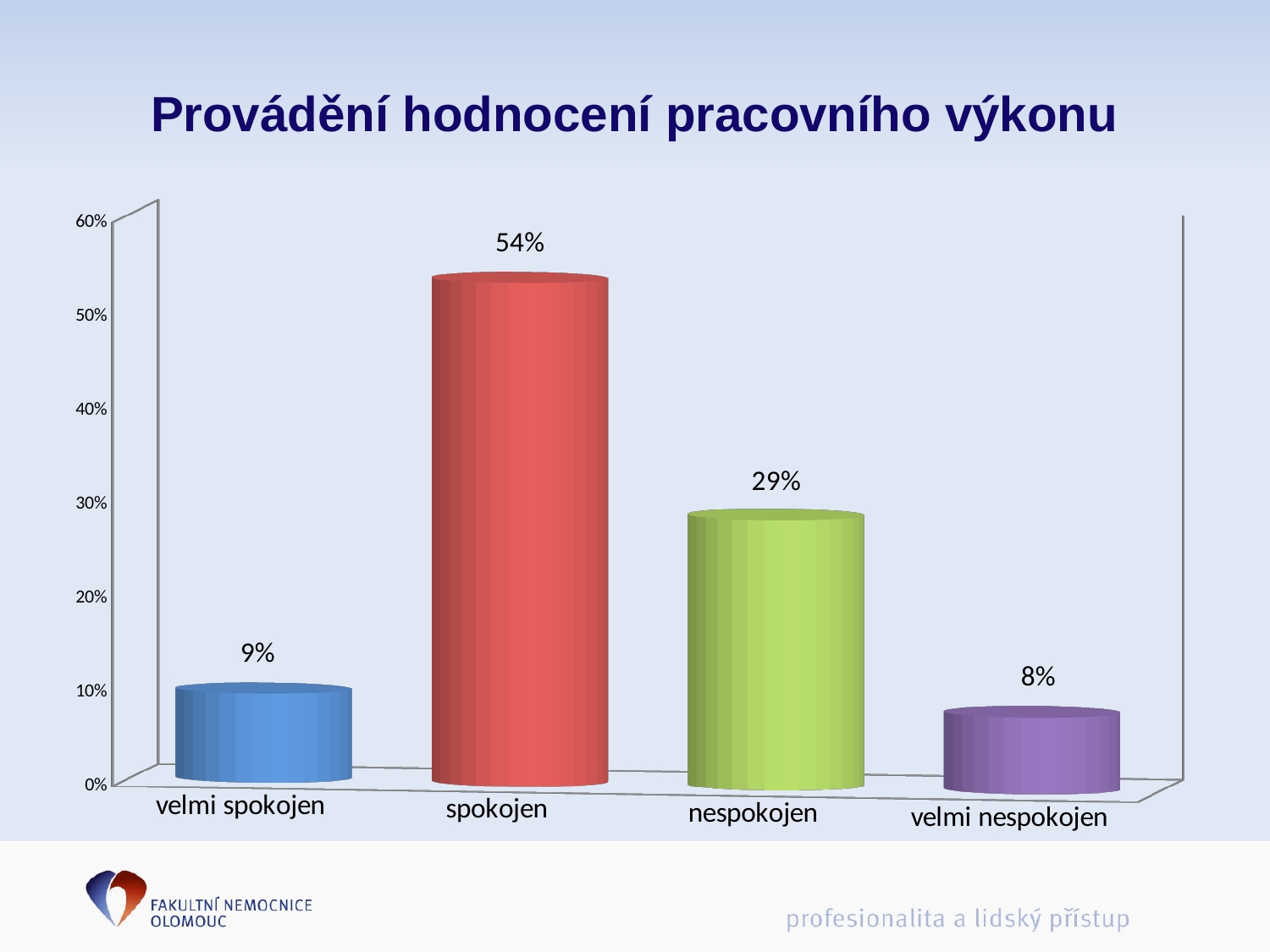
Which category has the lowest value? velmi nespokojen Which is larger, the value for "velmi spokojen" or the value for "velmi nespokojen"? velmi spokojen Which category has the highest value? spokojen How many categories are shown on the x axis? 4 What is the value for "spokojen"? 54% Is the value for "nespokojen" greater or less than 30%? less What kind of chart is shown on the slide? bar chart What is the difference between the values for "spokojen" and "nespokojen"? 25% What is the value for "velmi spokojen"? 9% What is the value for "velmi nespokojen"? 8% What is the title of the slide? Provádění hodnocení pracovního výkonu What is the value for "nespokojen"? 29%